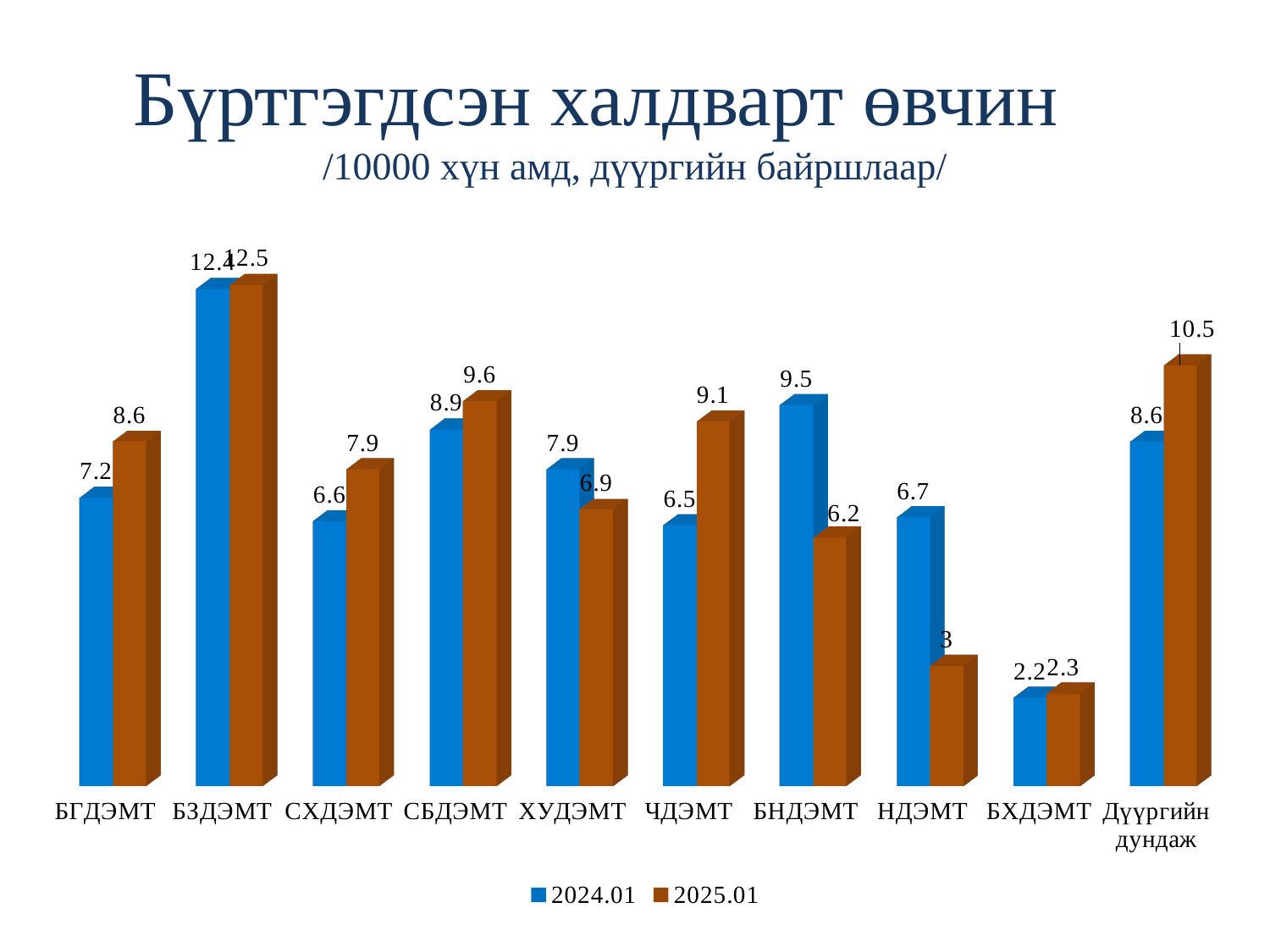
What is the difference between the 2025.01 and 2024.01 values for ЧДЭМТ? 2.6 Which category has the lowest 2024.01 value? БХДЭМТ How many series does the legend list? 2 What is the 2024.01 value for БНДЭМТ? 9.5 How many categories are shown on the x axis? 10 What is the 2025.01 value for НДЭМТ? 3 Which category has the highest 2025.01 value? БЗДЭМТ Which series is shown in blue? 2024.01 What kind of chart is shown on the slide? Bar chart Which is larger for ХУДЭМТ, the 2024.01 value or the 2025.01 value? 2024.01 What is the 2025.01 value for Дүүргийн дундаж? 10.5 What is the 2025.01 value for БГДЭМТ? 8.6